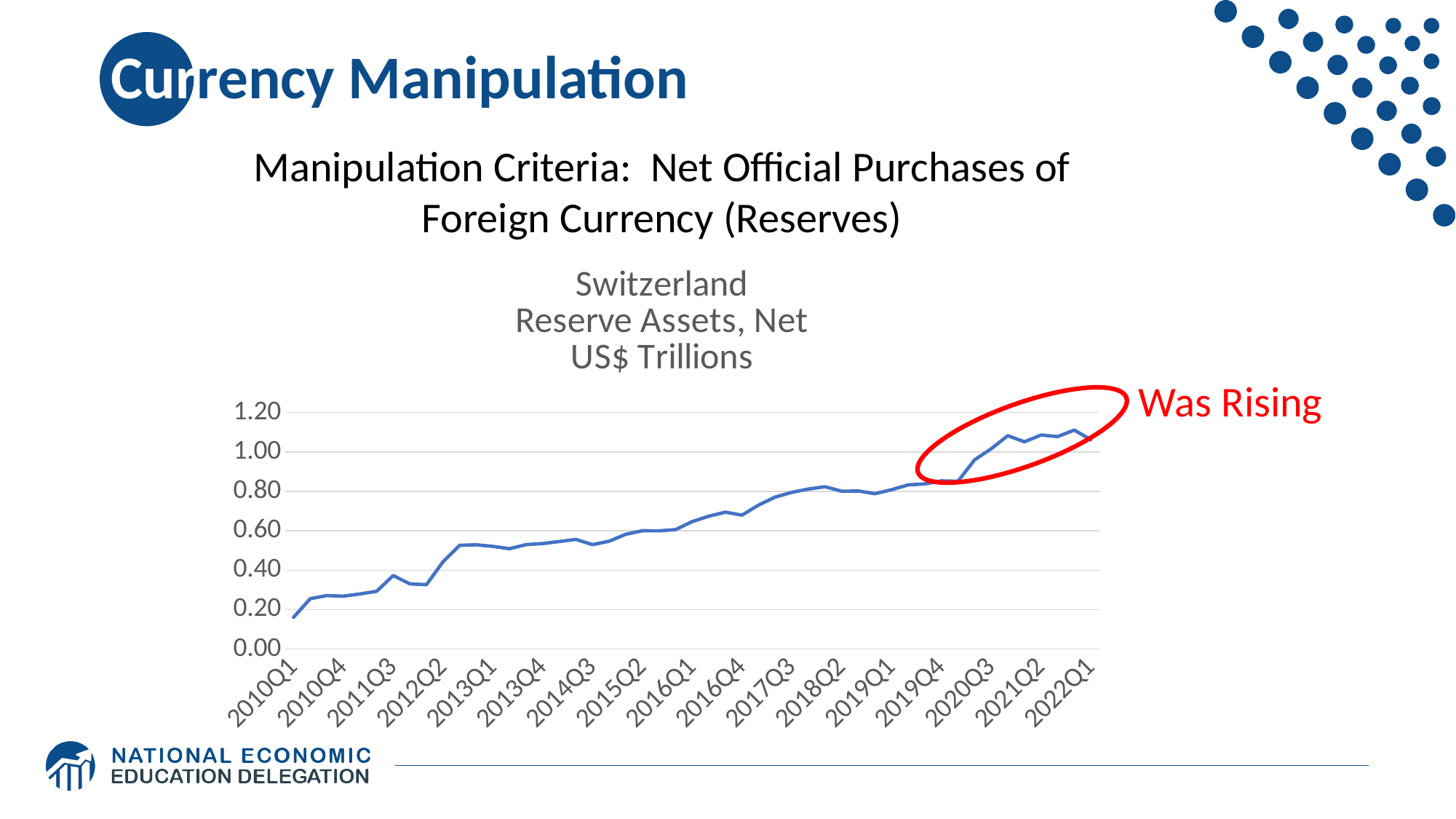
Is the value for 2022Q1 greater or less than 1.00? greater What does the red annotation next to the circled part of the line say? Was Rising What kind of chart is shown on the slide? Line chart Is the value for 2021Q2 greater or less than 1.00? greater Is the value for 2010Q1 greater or less than 0.20? less How many quarter labels are shown on the x axis? 17 Which is larger, the value for 2022Q1 or the value for 2010Q1? 2022Q1 Overall, do the values rise or fall from 2010Q1 to 2022Q1? Rise Which country's reserve assets does the chart show? Switzerland Which quarter has the lowest value on the chart? 2010Q1